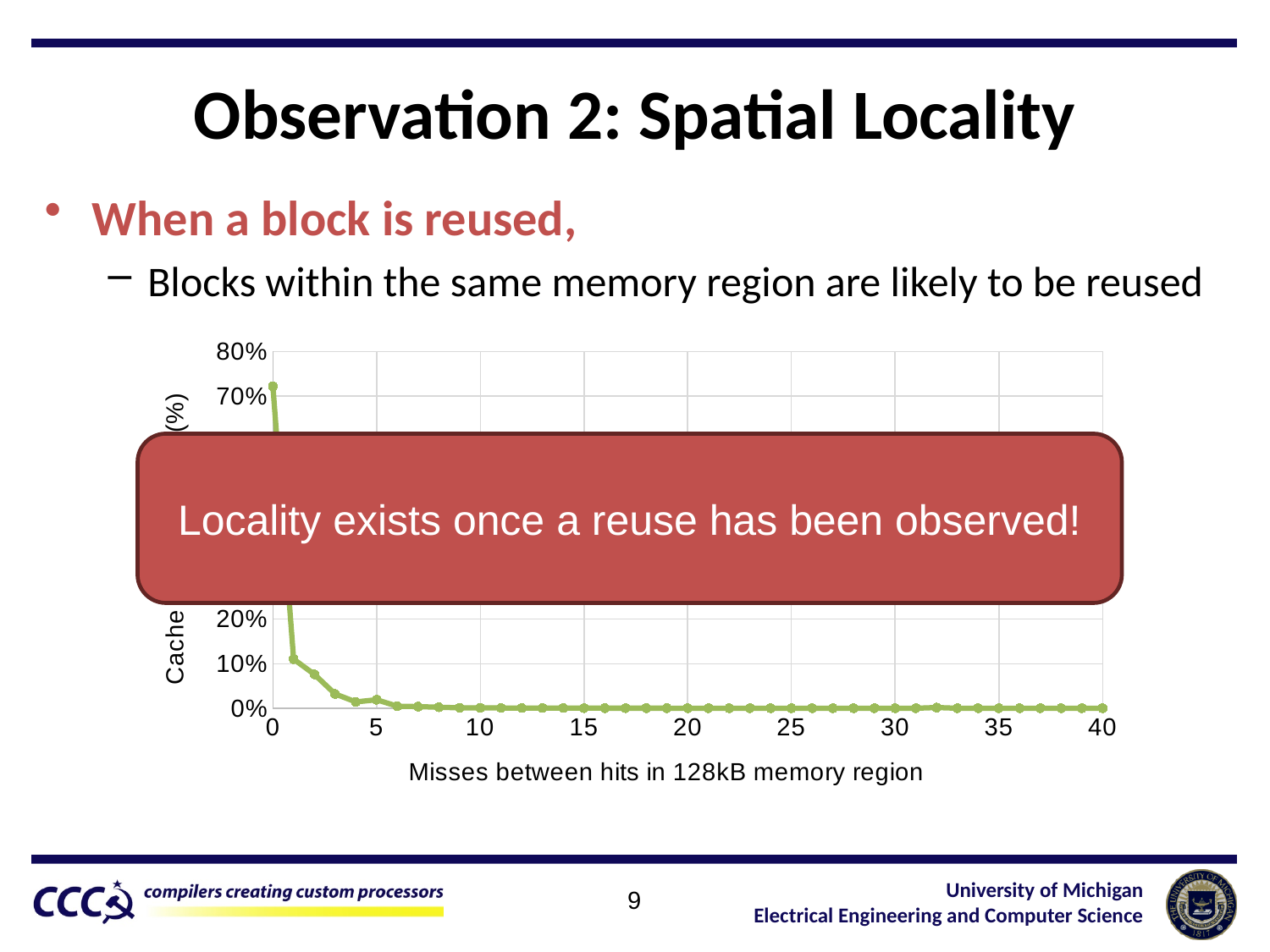
Which is larger, the value at 1 miss between hits or the value at 10 misses between hits? 1 miss between hits At which x-axis value is the plotted value highest? 0 Which is larger, the value at 0 misses between hits or the value at 1 miss between hits? 0 misses between hits What kind of chart is shown on the slide? Line chart What is the highest tick value shown on the y axis of the chart? 80% Is the value at 2 misses between hits greater or less than 10%? less Do the values rise or fall as the number of misses between hits increases along the x axis? Fall Is the value at 1 miss between hits greater or less than 20%? less What is the label of the x axis of the chart? Misses between hits in 128kB memory region Is the value at 0 misses between hits greater or less than 60%? greater What is the largest value shown on the x axis of the chart? 40